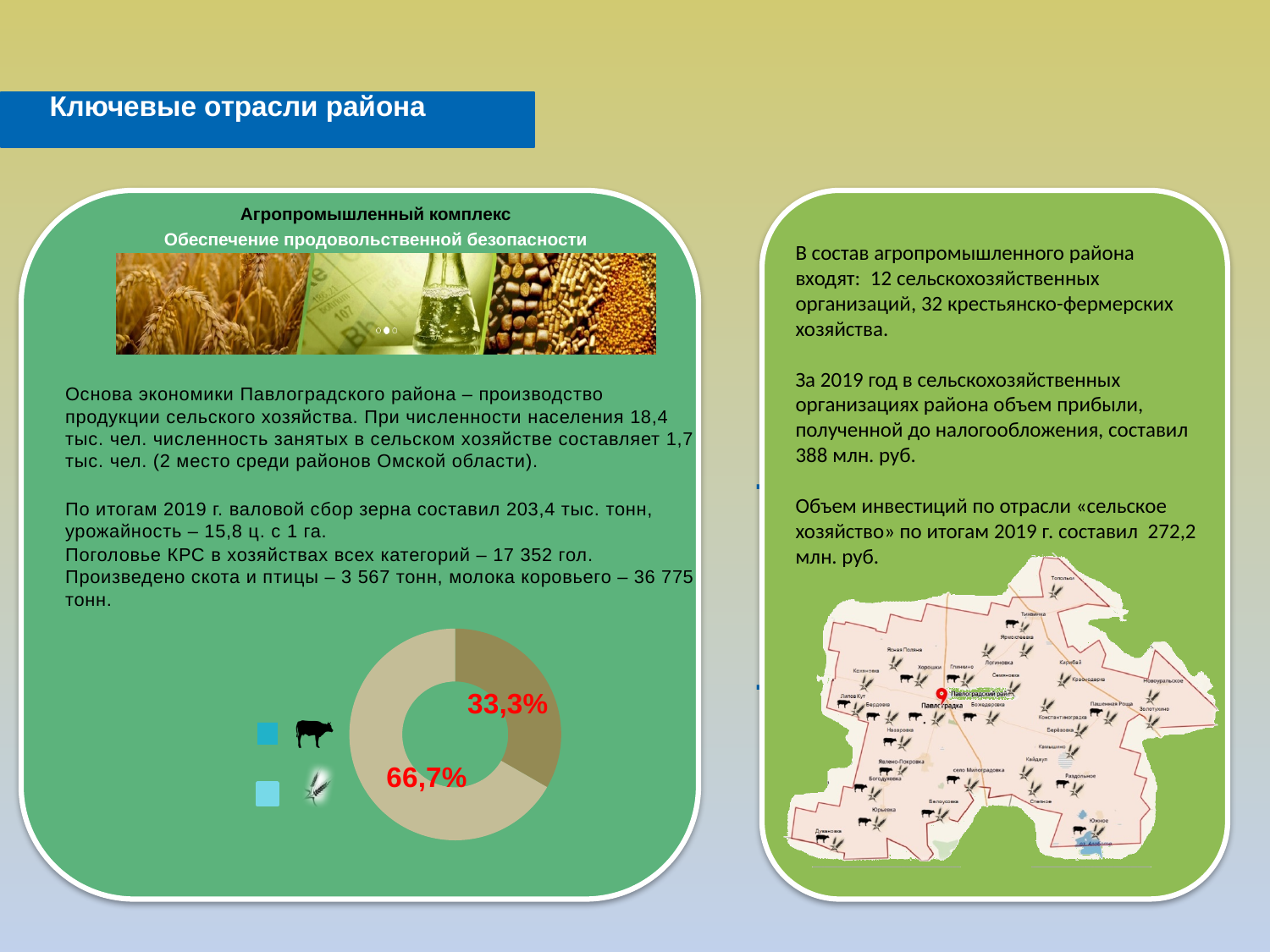
What do the two slice values of the donut chart add up to? 100% What is the value of the smallest slice in the donut chart? 33,3% What value is printed on the lower-left slice of the donut chart? 66,7% What value is printed on the upper-right slice of the donut chart? 33,3% What is the value of the largest slice in the donut chart? 66,7% How many slices does the donut chart have? 2 What is the difference between the two slice values in the donut chart? 33,4 percentage points How many entries does the legend next to the donut chart show? 2 What kind of chart is shown in the lower part of the left panel? pie chart (donut) Which slice value is larger in the donut chart, 33,3% or 66,7%? 66,7% Is the larger slice of the donut chart greater or less than 50%? greater What two icons are used in the legend next to the donut chart? a cow and an ear of wheat